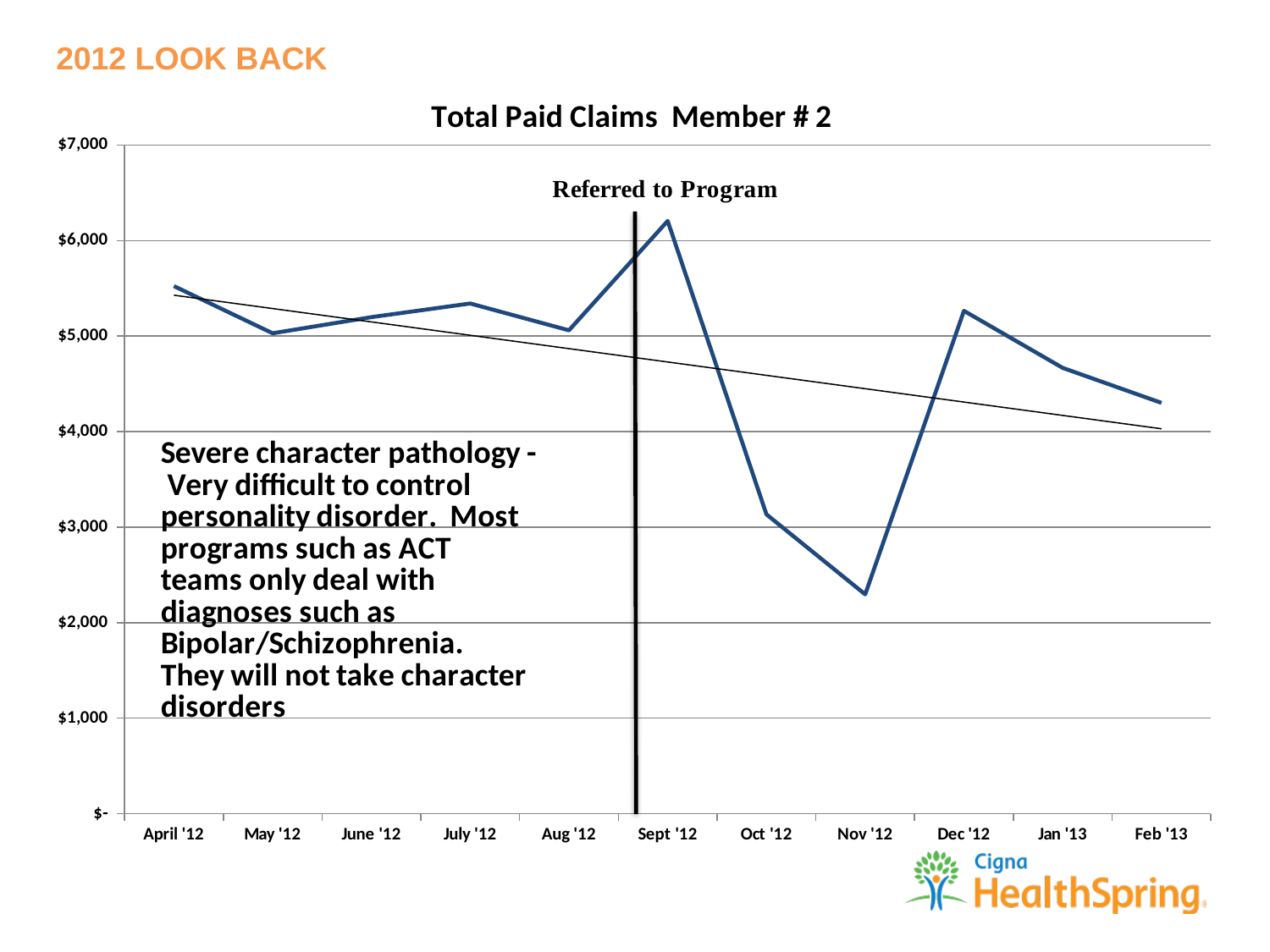
How many months are plotted along the x axis? 11 Which month has the highest total paid claims? Sept '12 Which month has the lowest total paid claims? Nov '12 Which is larger, the value for Oct '12 or the value for Dec '12? Dec '12 What kind of chart is shown on the slide? line chart Is the value for Dec '12 greater or less than $5,000? greater What label is shown next to the vertical black line on the chart? Referred to Program Is the value for Sept '12 greater or less than $6,000? greater Do the values rise or fall from Sept '12 to Nov '12? fall What is the title of the chart? Total Paid Claims Member # 2 Is the value for Nov '12 greater or less than $3,000? less